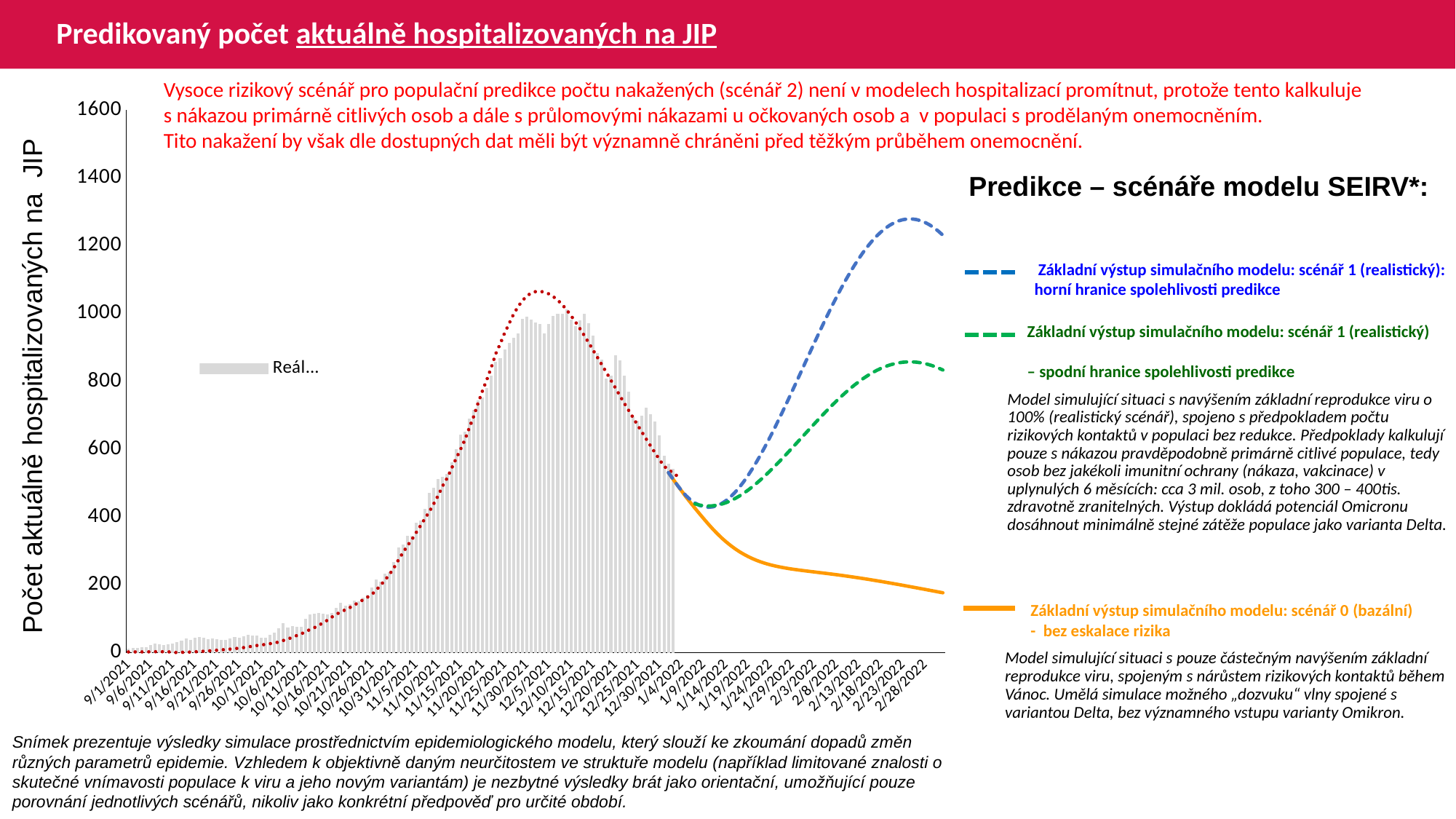
Is the value of the orange line at 2/28/2022 greater or less than 400? less Is the peak value of the grey bars (around 12/5/2021) greater or less than 1200? less Is the peak of the blue dashed line (around 2/23/2022) greater or less than 1200? greater What is the title of the chart on the slide? Predikovaný počet aktuálně hospitalizovaných na JIP What is the label of the vertical axis of the chart? Počet aktuálně hospitalizovaných na JIP Does the orange line rise or fall between 1/9/2022 and 2/28/2022? Fall What is the highest tick value shown on the vertical axis? 1600 What kind of chart is shown on the slide? Bar chart combined with line series At 2/28/2022, which line has the larger value: the blue dashed line or the orange line? Blue dashed line